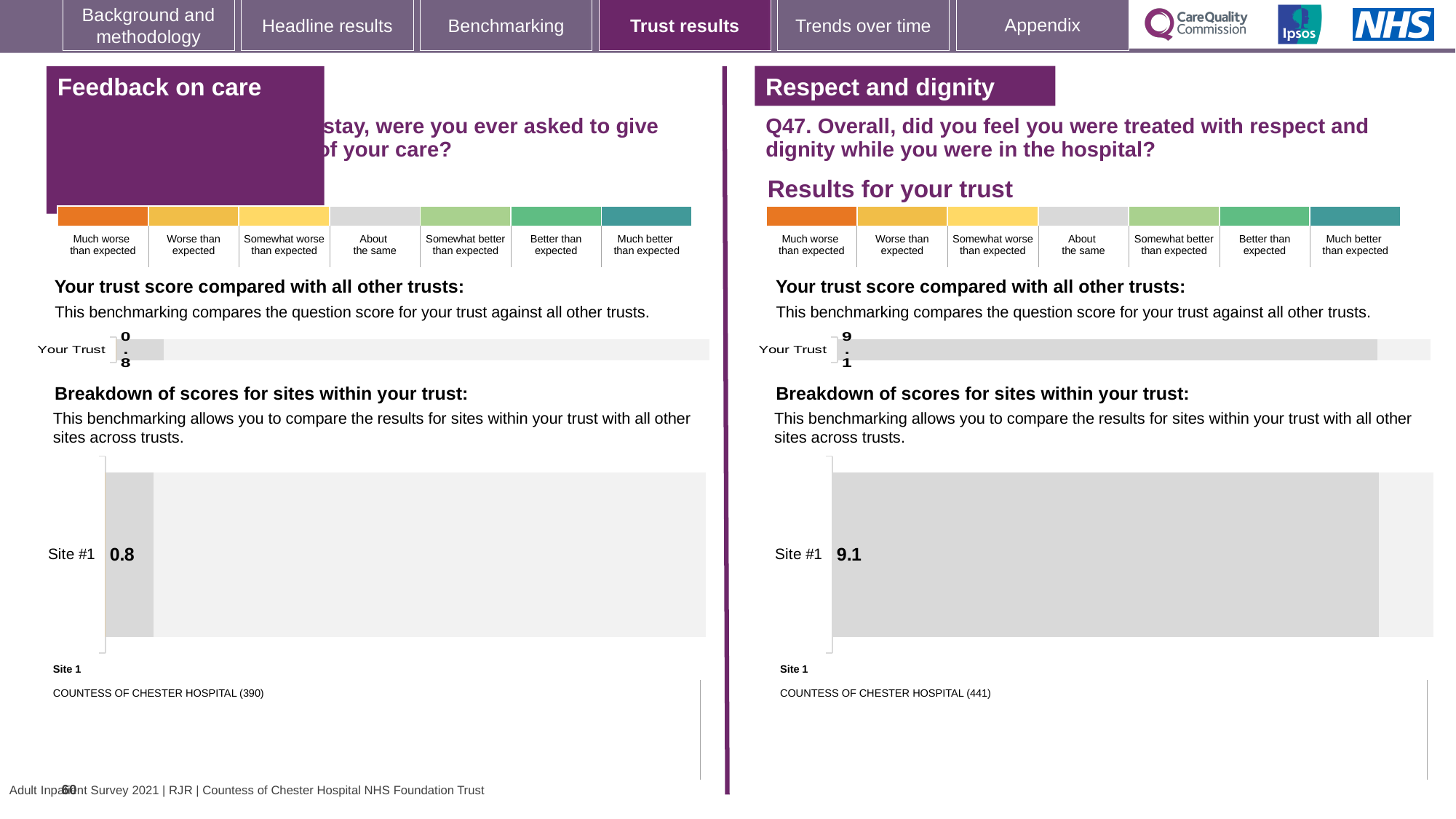
What kind of chart is used to show the Your Trust score under 'Feedback on care'? Bar chart On the 'Feedback on care' section, what is the score shown for Your Trust in the 'Your trust score compared with all other trusts' chart? 0.8 What kind of chart is used to show the Site #1 score under 'Respect and dignity'? Bar chart What is the difference between the Site #1 score in the 'Respect and dignity' breakdown chart and the Site #1 score in the 'Feedback on care' breakdown chart? 8.3 Which site is listed as Site 1 below the 'Respect and dignity' breakdown chart? COUNTESS OF CHESTER HOSPITAL (441) In the 'Breakdown of scores for sites within your trust' chart under 'Respect and dignity', what is the value for Site #1? 9.1 How many sites are plotted in the 'Breakdown of scores for sites within your trust' chart under 'Respect and dignity'? 1 Which is larger: the Site #1 score in the 'Feedback on care' breakdown chart or the Site #1 score in the 'Respect and dignity' breakdown chart? Respect and dignity On the 'Respect and dignity' section, what is the score shown for Your Trust in the 'Your trust score compared with all other trusts' chart? 9.1 In the 'Breakdown of scores for sites within your trust' chart under 'Feedback on care', what is the value for Site #1? 0.8 Which site is listed as Site 1 below the 'Feedback on care' breakdown chart? COUNTESS OF CHESTER HOSPITAL (390) How many sites are plotted in the 'Breakdown of scores for sites within your trust' chart under 'Feedback on care'? 1